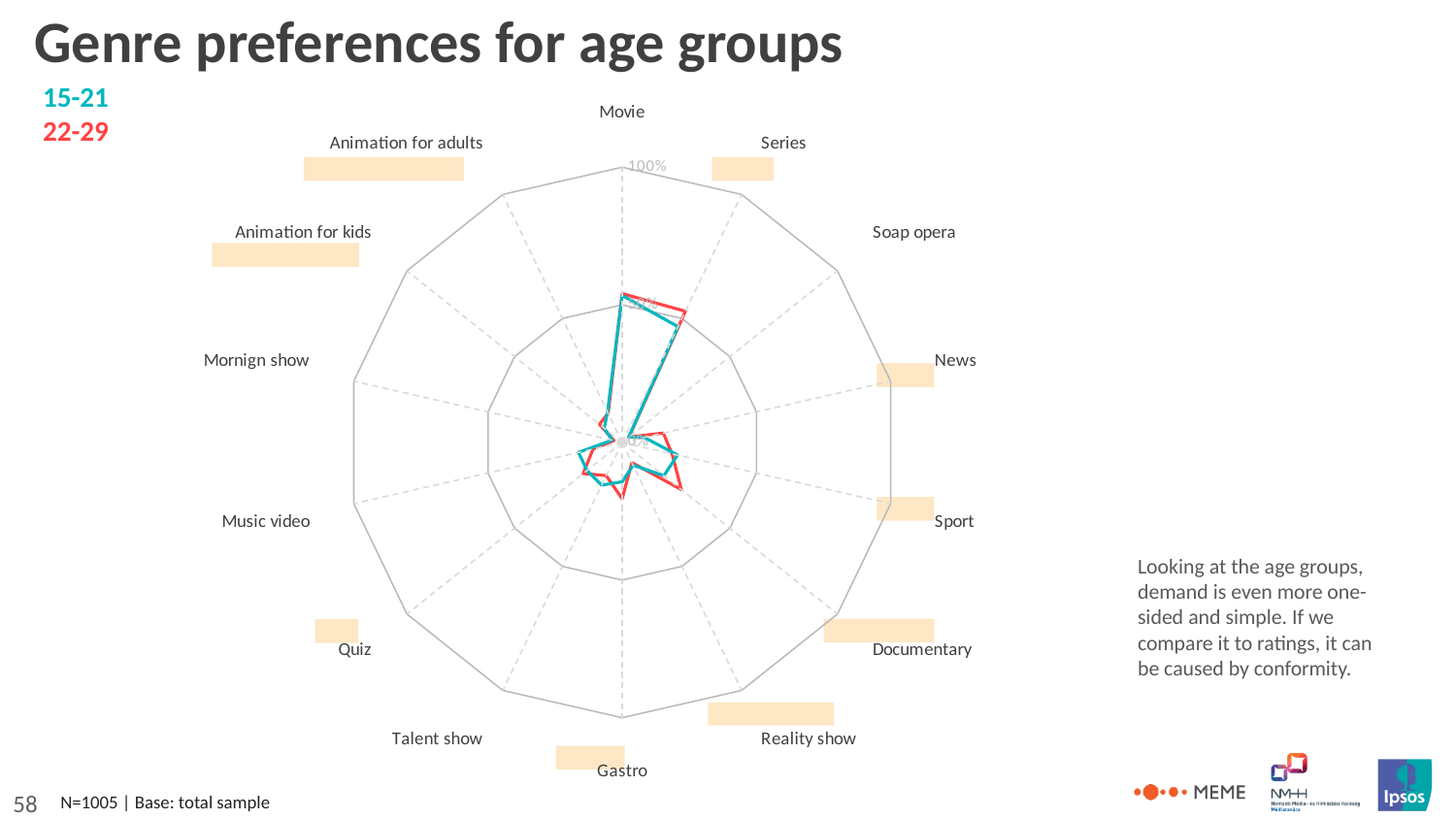
What is the title of the chart on the slide? Genre preferences for age groups Which is larger for the 15-21 group, the value for Movie or the value for Quiz? Movie Is the value for Documentary for the 15-21 group greater or less than 50%? less How many series does the chart's legend list? 2 How many genre categories are plotted around the radar chart? 14 Is the value for News for the 22-29 group greater or less than 50%? less Is the value for Sport for the 15-21 group greater or less than 50%? less What percentage does the outermost ring of the radar chart represent? 100% Which two age groups are plotted on the chart? 15-21 and 22-29 What kind of chart is shown on the slide? Radar chart